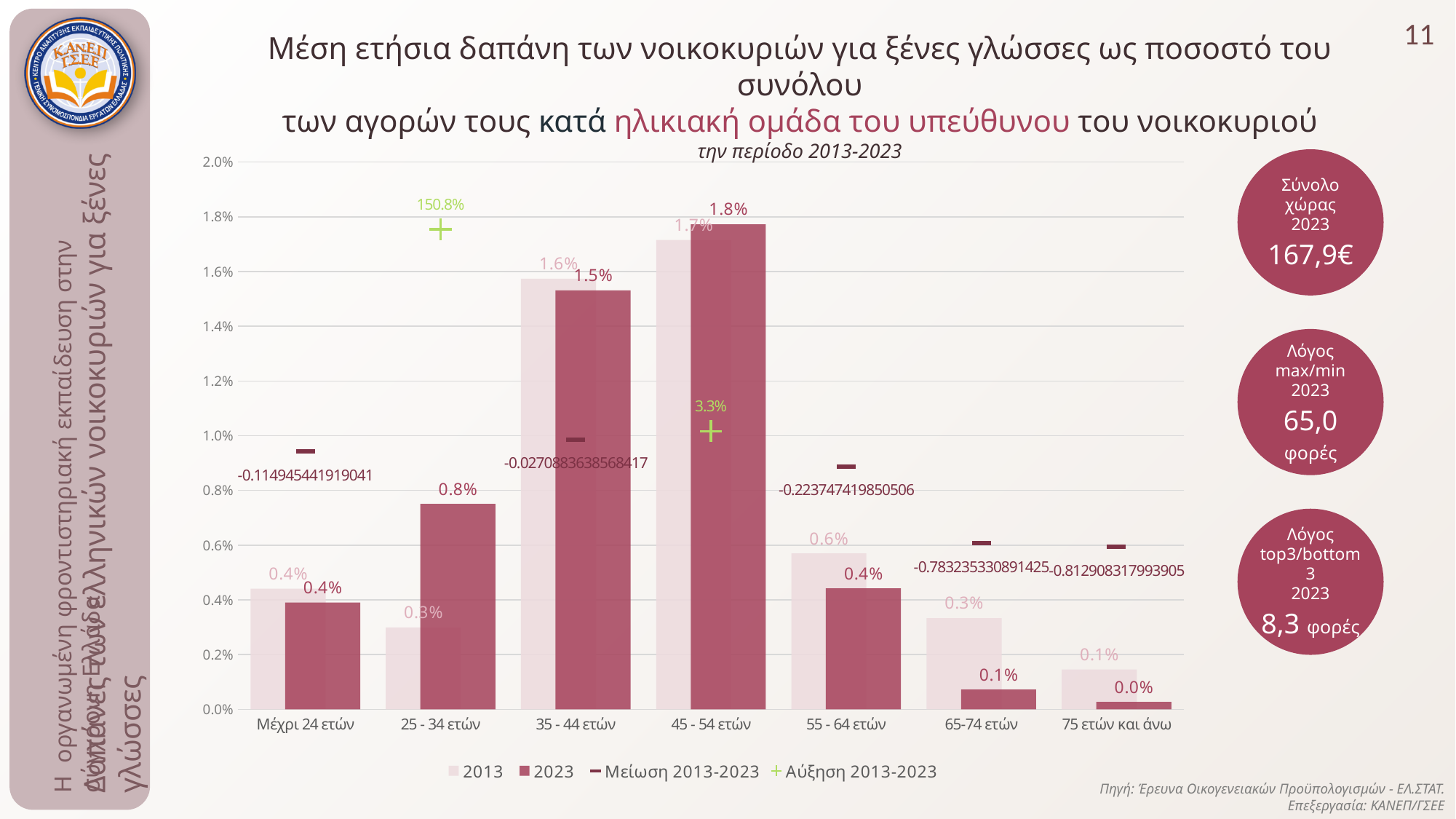
Which age group has the highest 2023 value? 45 - 54 ετών What is the 2023 value for the 45 - 54 ετών age group? 1.8% How many age-group categories are shown on the x axis? 7 What is the 2023 value for the 25 - 34 ετών age group? 0.8% What is the difference between the 2023 values for 45 - 54 ετών and 35 - 44 ετών? 0.3% What type of chart is shown on the slide? bar chart What is the 2023 value for the 75 ετών και άνω age group? 0.0% Which is larger for the 25 - 34 ετών age group: the 2013 value or the 2023 value? 2023 What is the percentage increase shown for the 25 - 34 ετών age group between 2013 and 2023? 150.8% How many entries does the legend list? 4 What is the 2013 value for the 35 - 44 ετών age group? 1.6% Which age group has the lowest 2023 value? 75 ετών και άνω